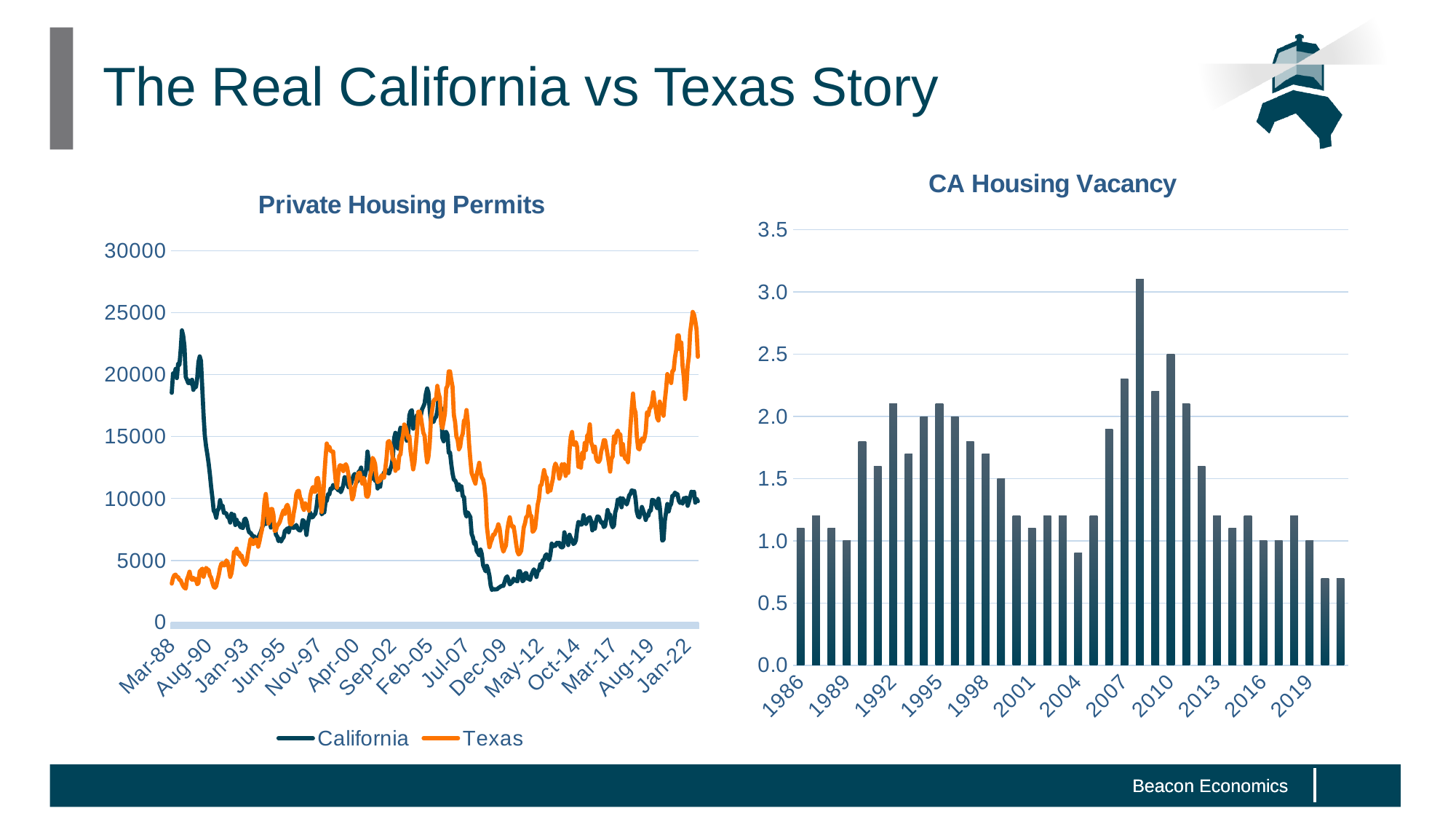
In the Private Housing Permits chart, which colour is the Texas line? orange In the Private Housing Permits chart, which series is higher at Jan-22, California or Texas? Texas In the CA Housing Vacancy chart, is the tallest bar greater or less than 3.0? greater What kind of chart is the Private Housing Permits chart? line chart What kind of chart is the CA Housing Vacancy chart? bar chart In the CA Housing Vacancy chart, is the value for 2007 greater or less than 2.0? greater How many series does the legend of the Private Housing Permits chart list? 2 In the Private Housing Permits chart, does the Texas series overall rise or fall from Mar-88 to Jan-22? rise In the Private Housing Permits chart, is the California value at Jan-22 greater or less than 15000? less In the Private Housing Permits chart, which series is higher at Mar-88, California or Texas? California